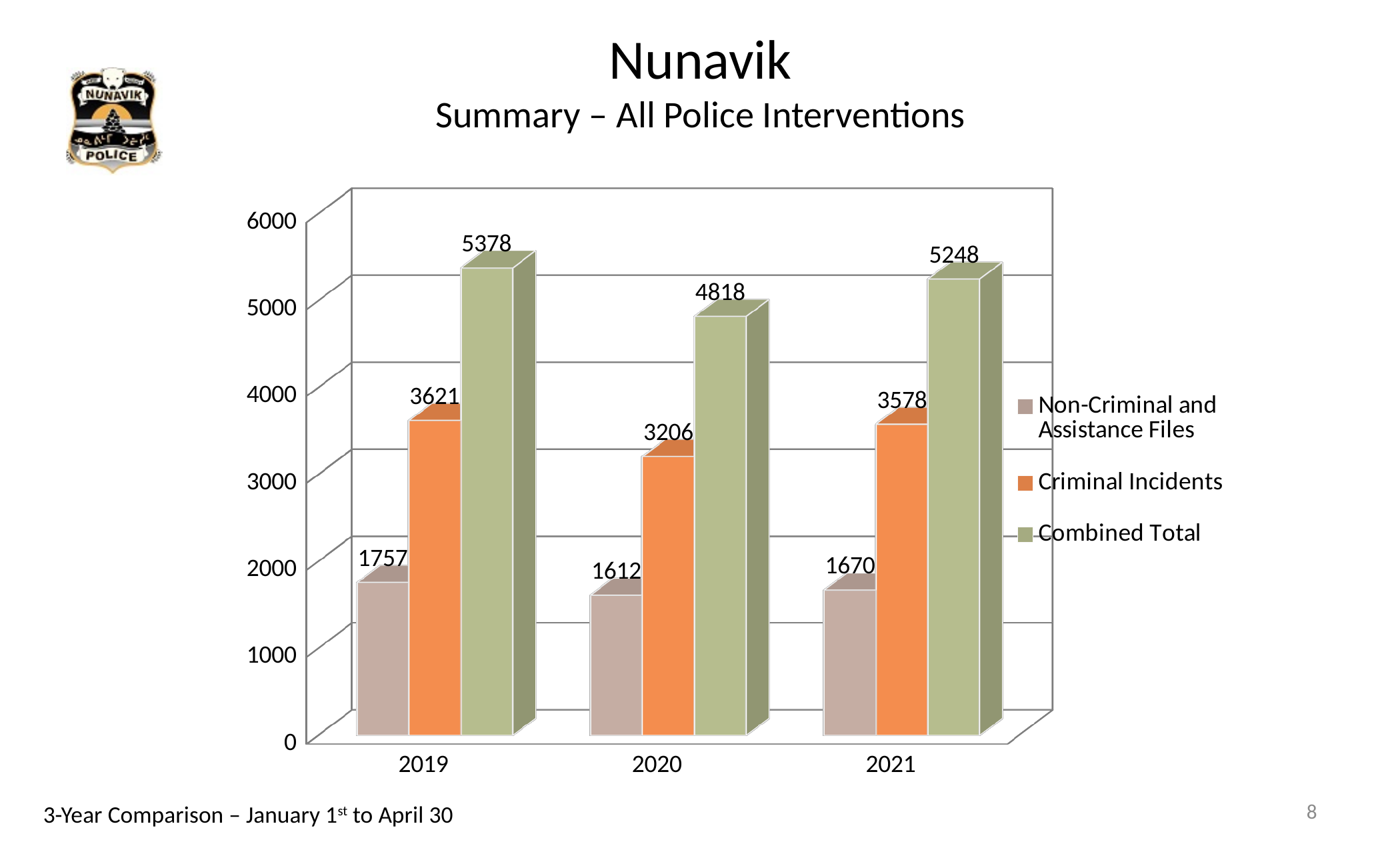
Which year has the lowest value for Non-Criminal and Assistance Files? 2020 Which is larger: Criminal Incidents in 2019 or Criminal Incidents in 2021? Criminal Incidents in 2019 What is the difference between the Combined Total in 2019 and in 2020? 560 What kind of chart is shown on the slide? bar chart How many years are shown on the x axis? 3 What is the difference between Criminal Incidents in 2021 and in 2020? 372 What is the value for Criminal Incidents in 2020? 3206 What is the value for Non-Criminal and Assistance Files in 2019? 1757 What is the Combined Total for 2021? 5248 How many series does the legend list? 3 Is the Combined Total for 2020 greater or less than 5000? less Which year has the highest Combined Total? 2019